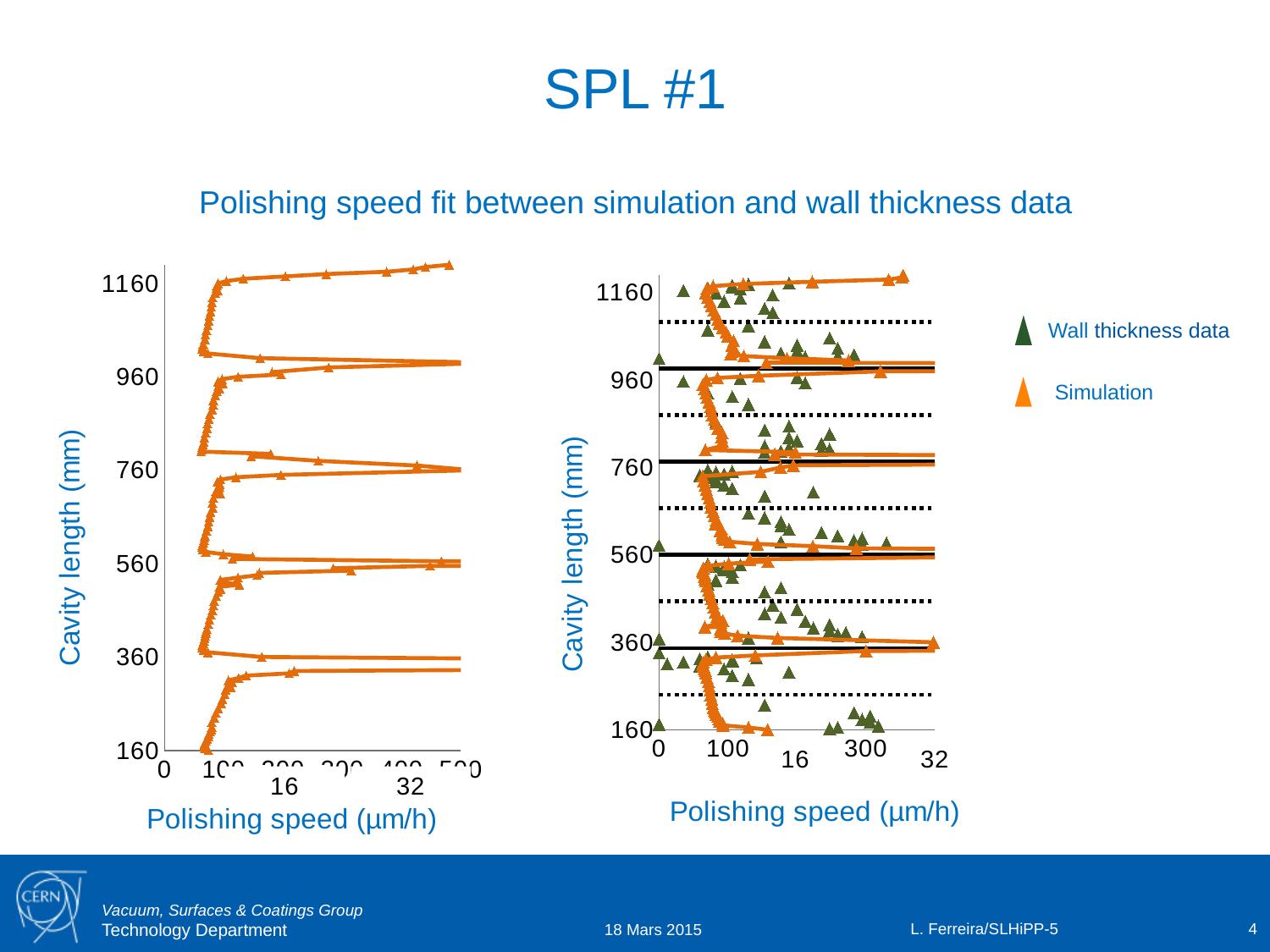
On the left-hand chart, is the Simulation polishing speed at a cavity length of 460 mm greater or less than 100? less How many charts are shown on the slide? 2 What is the title of the y-axis on the left-hand chart? Cavity length (mm) What is the title of the x-axis on the right-hand chart? Polishing speed (µm/h) On the left-hand chart, what is the highest value labelled on the y-axis? 1160 On the right-hand chart, how many solid horizontal black lines are drawn across the plot? 4 How many series does the legend list? 2 On the left-hand chart, how many sharp peaks does the Simulation curve show? 5 What kind of chart is the right-hand chart? Scatter chart with lines (line chart)